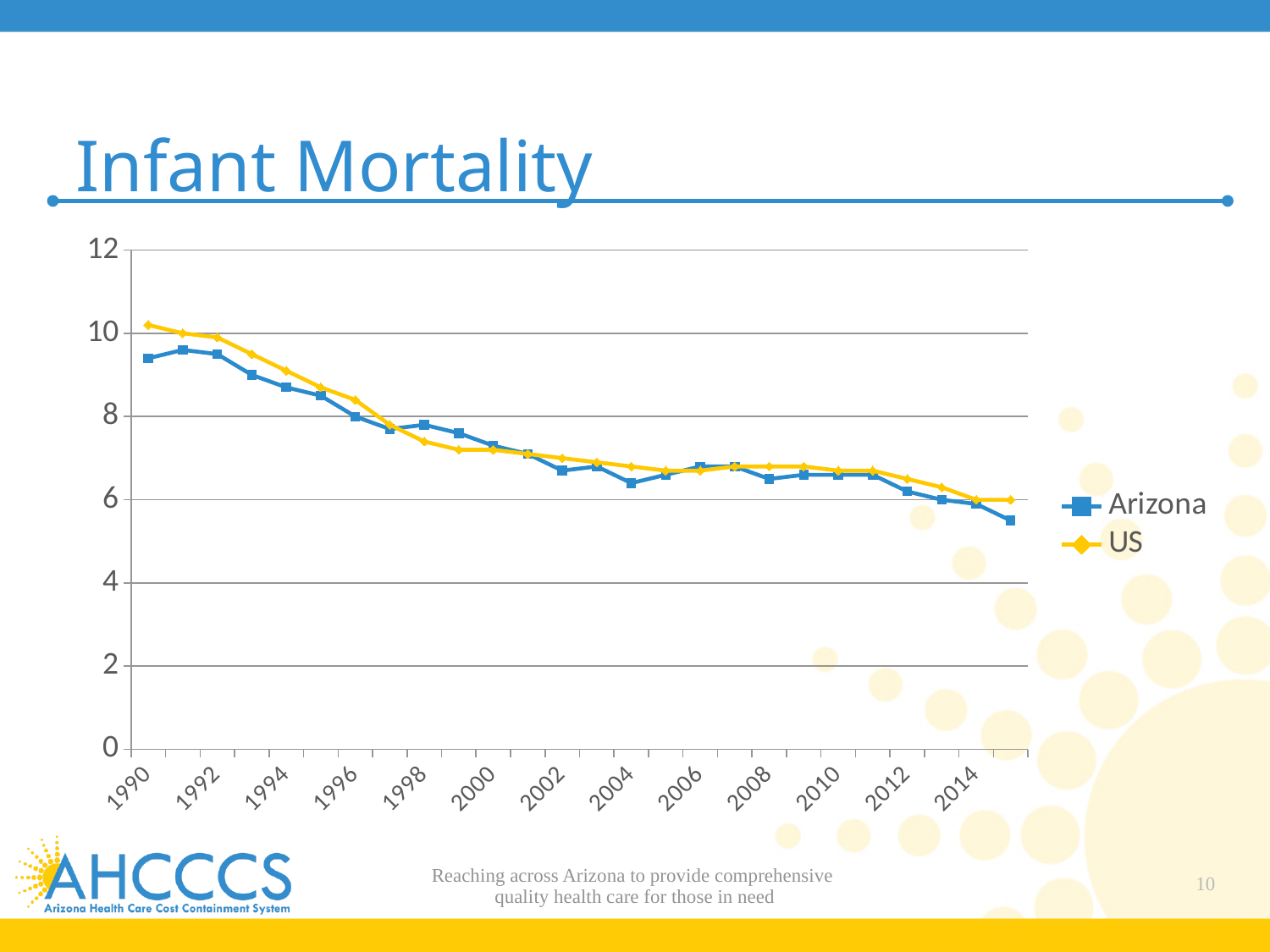
What is the title of the chart? Infant Mortality What kind of chart is shown on the slide? Line chart Is the US value for 1996 greater or less than 8? greater Is the Arizona value for 2004 greater or less than 8? less In 1990, which series has the higher value, Arizona or US? US In 2015, which series has the higher value, Arizona or US? US In which year is the Arizona value lowest? 2015 How many series does the legend list? 2 Do the Arizona values rise or fall from 1990 to 2015? Fall Is the Arizona value for 2015 greater or less than 6? less Which colour is used for the US series? Yellow